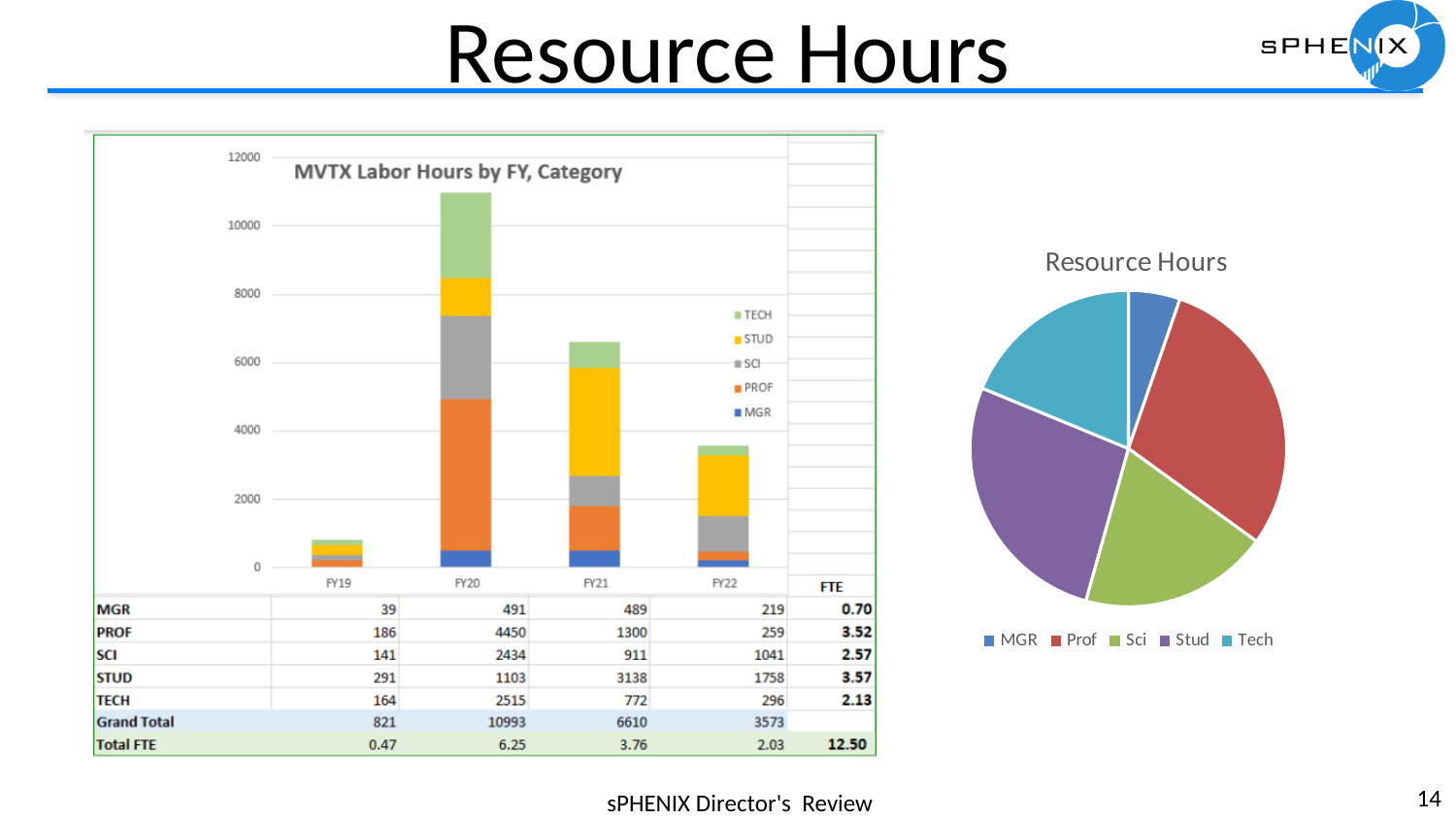
In the 'Resource Hours' pie chart, which category has the smallest slice? MGR In the 'MVTX Labor Hours by FY, Category' chart, what is the STUD value for FY21? 3138 In the 'MVTX Labor Hours by FY, Category' chart, which is larger for FY22: SCI or TECH? SCI How many fiscal years are shown on the x axis of the 'MVTX Labor Hours by FY, Category' chart? 4 In the 'MVTX Labor Hours by FY, Category' chart, which fiscal year has the lowest grand total of labor hours? FY19 How many series does the legend of the 'MVTX Labor Hours by FY, Category' chart list? 5 In the 'MVTX Labor Hours by FY, Category' chart, which fiscal year has the highest grand total of labor hours? FY20 In the 'MVTX Labor Hours by FY, Category' chart, what is the difference between the FY20 grand total and the FY21 grand total? 4383 What kind of chart is the 'Resource Hours' chart on the right? Pie chart In the 'MVTX Labor Hours by FY, Category' chart, what is the grand total for FY22? 3573 In the 'MVTX Labor Hours by FY, Category' chart, what is the PROF value for FY20? 4450 What kind of chart is the 'MVTX Labor Hours by FY, Category' chart on the left? Stacked bar chart